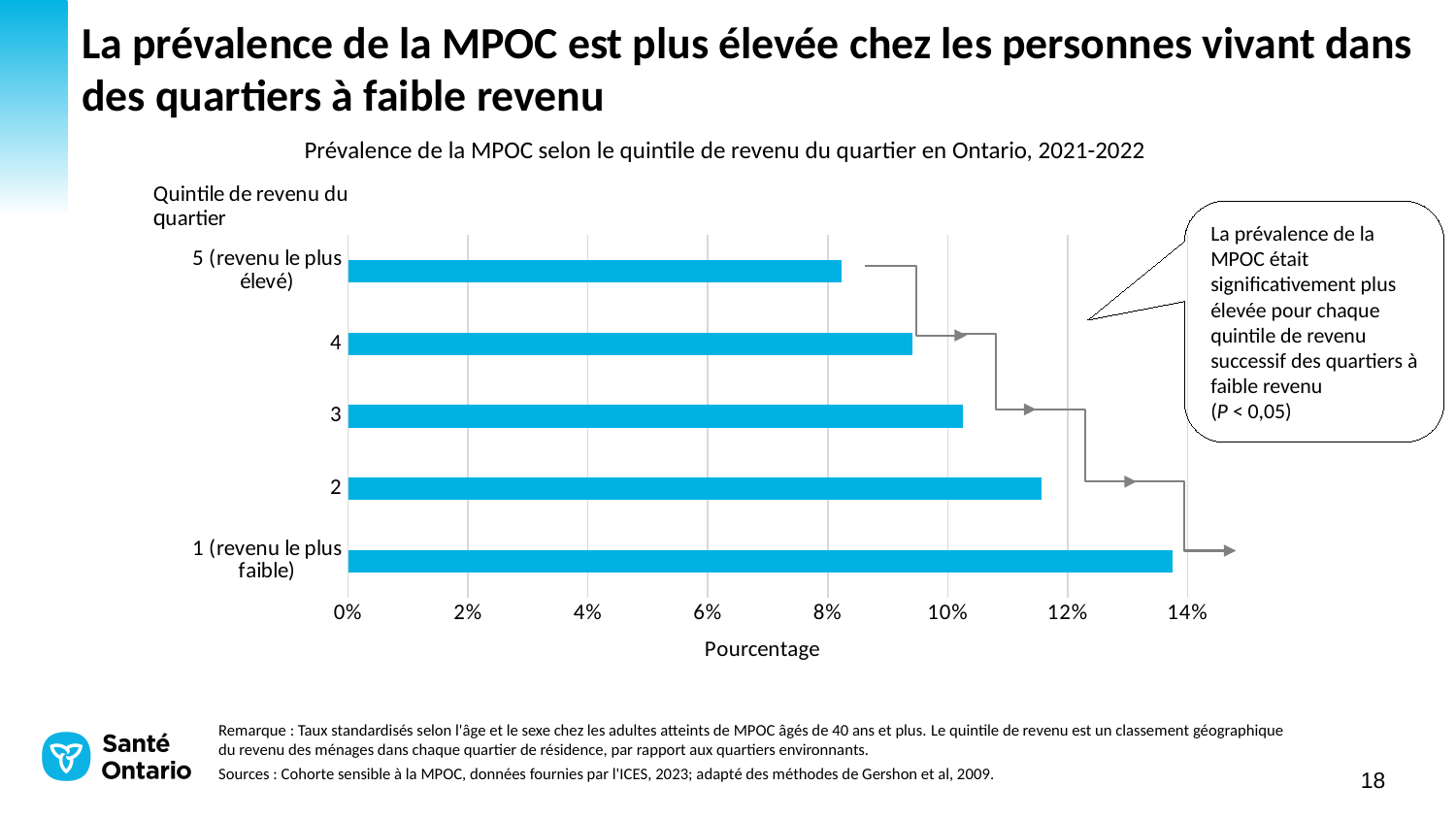
How many income quintile categories are plotted in the chart? 5 Which has a lower prevalence: quintile 3 or quintile 5 (revenu le plus élevé)? quintile 5 (revenu le plus élevé) Is the value for quintile 2 greater or less than 10%? greater What kind of chart is shown on the slide? bar chart Which income quintile has the lowest COPD prevalence in the chart? 5 (revenu le plus élevé) Which income quintile has the highest COPD prevalence in the chart? 1 (revenu le plus faible) Which has a higher prevalence: quintile 2 or quintile 4? quintile 2 Is the value for quintile 4 greater or less than 10%? less What is the title of the chart? Prévalence de la MPOC selon le quintile de revenu du quartier en Ontario, 2021-2022 Is the value for quintile 1 (revenu le plus faible) greater or less than 12%? greater Does COPD prevalence rise or fall as the neighbourhood income quintile goes from 1 (lowest income) to 5 (highest income)? fall